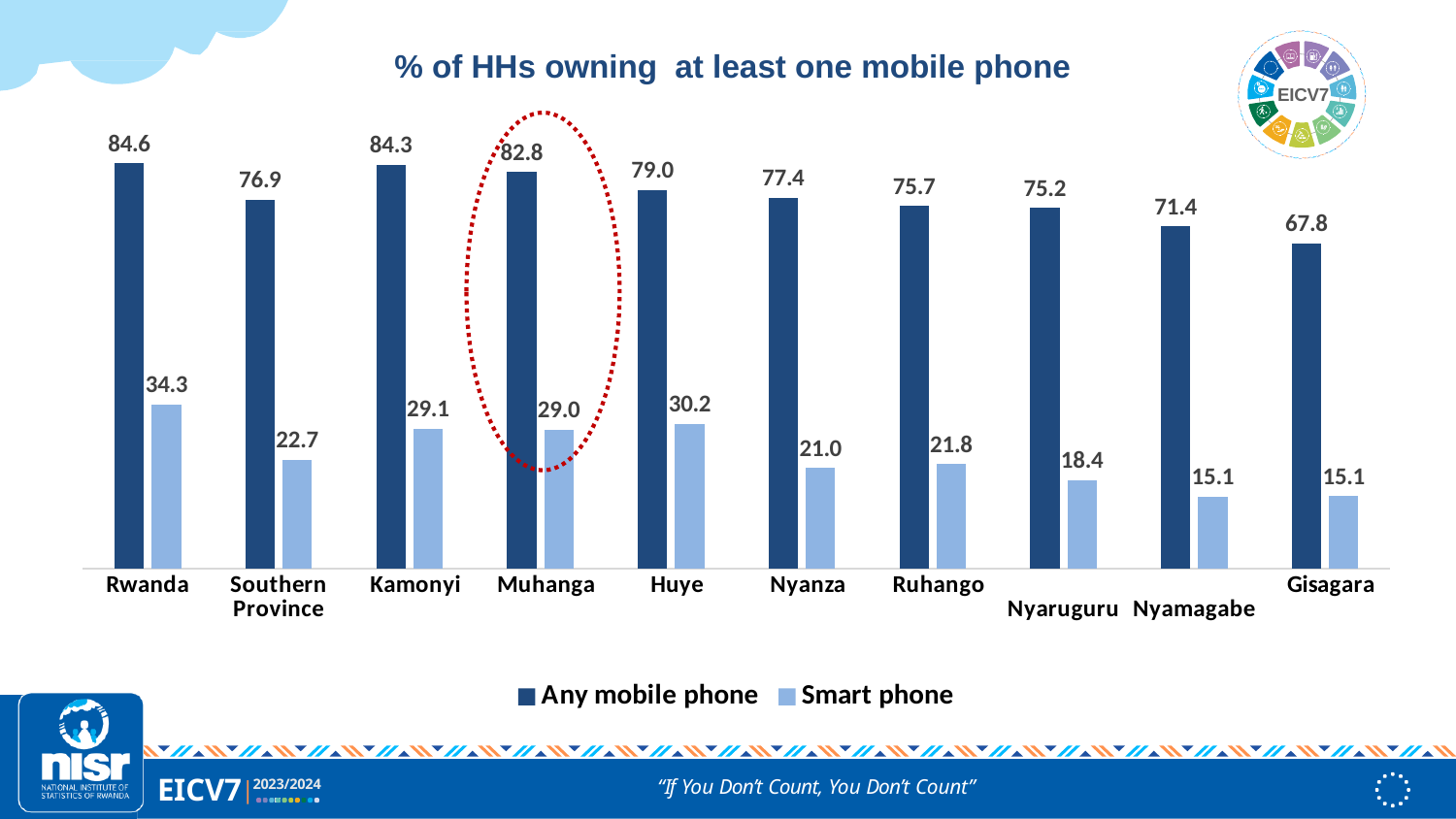
What is the value for Any mobile phone in Muhanga? 82.8 Which category has the lowest value for Any mobile phone? Gisagara Which category has the highest value for Smart phone? Rwanda How many series does the legend list? 2 What is the difference between the Any mobile phone and Smart phone values for Southern Province? 54.2 What type of chart is shown on the slide? Bar chart Does the Any mobile phone value generally rise or fall from Kamonyi to Gisagara along the x axis? Fall What is the value for Any mobile phone in Nyaruguru? 75.2 What is the value for Smart phone in Huye? 30.2 Which is larger, the Smart phone value for Kamonyi or for Nyanza? Kamonyi How many categories are shown on the x axis? 10 What is the title of the chart? % of HHs owning at least one mobile phone